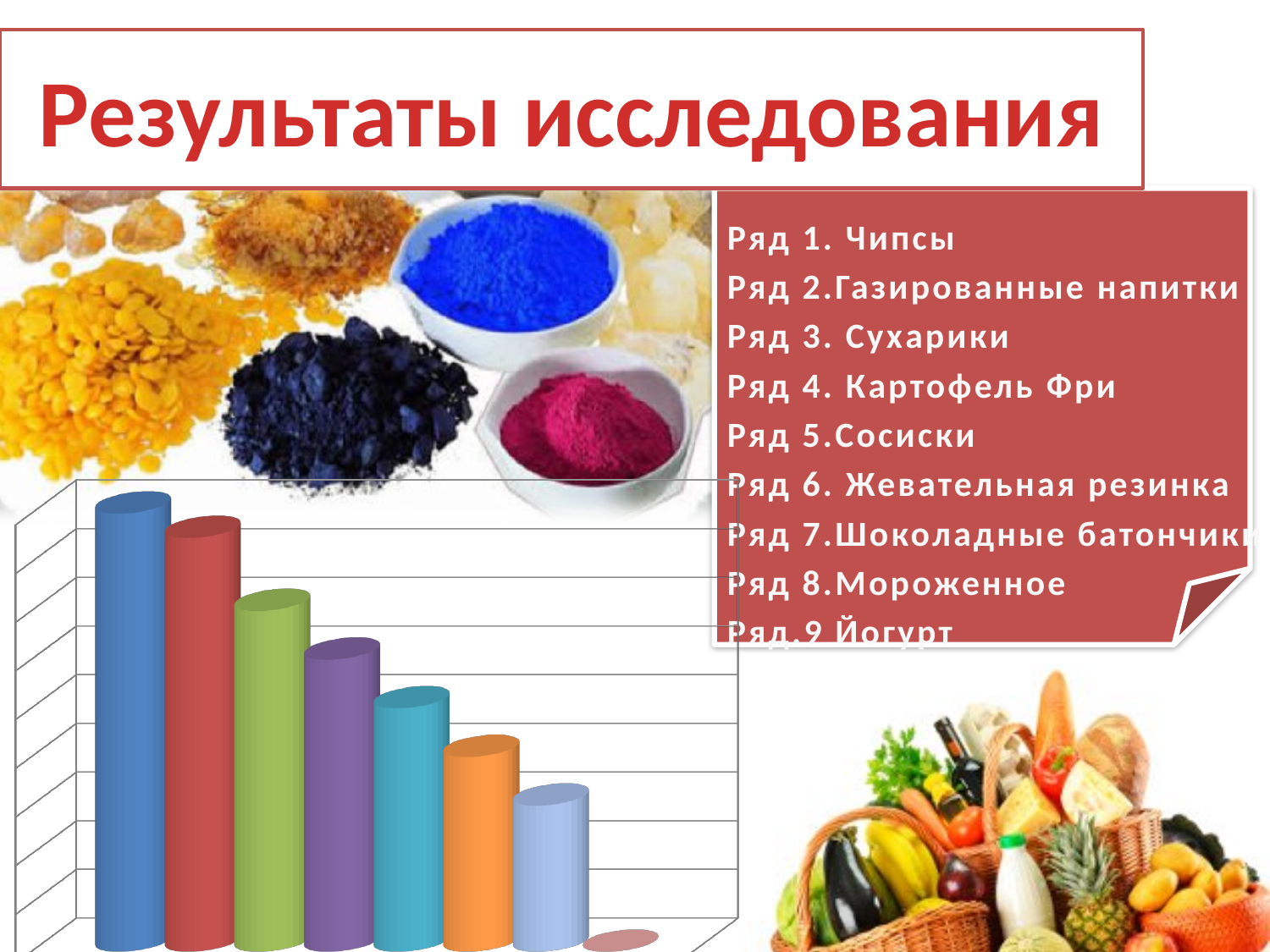
What food item does the text box list for Ряд 1? Чипсы What food item does the text box list for Ряд 9? Йогурт Which is taller, the green bar or the orange bar? the green bar Does the chart display any numeric data labels on its bars? no Which is shorter, the teal bar or the red bar? the teal bar Do the bar heights rise or fall from left to right across the chart? fall Which is taller, the blue bar or the red bar? the blue bar Which bar in the chart is the tallest? the leftmost (blue) bar What kind of chart is shown on the slide? bar chart How many series does the text box on the slide list (Ряд 1 to Ряд 9)? 9